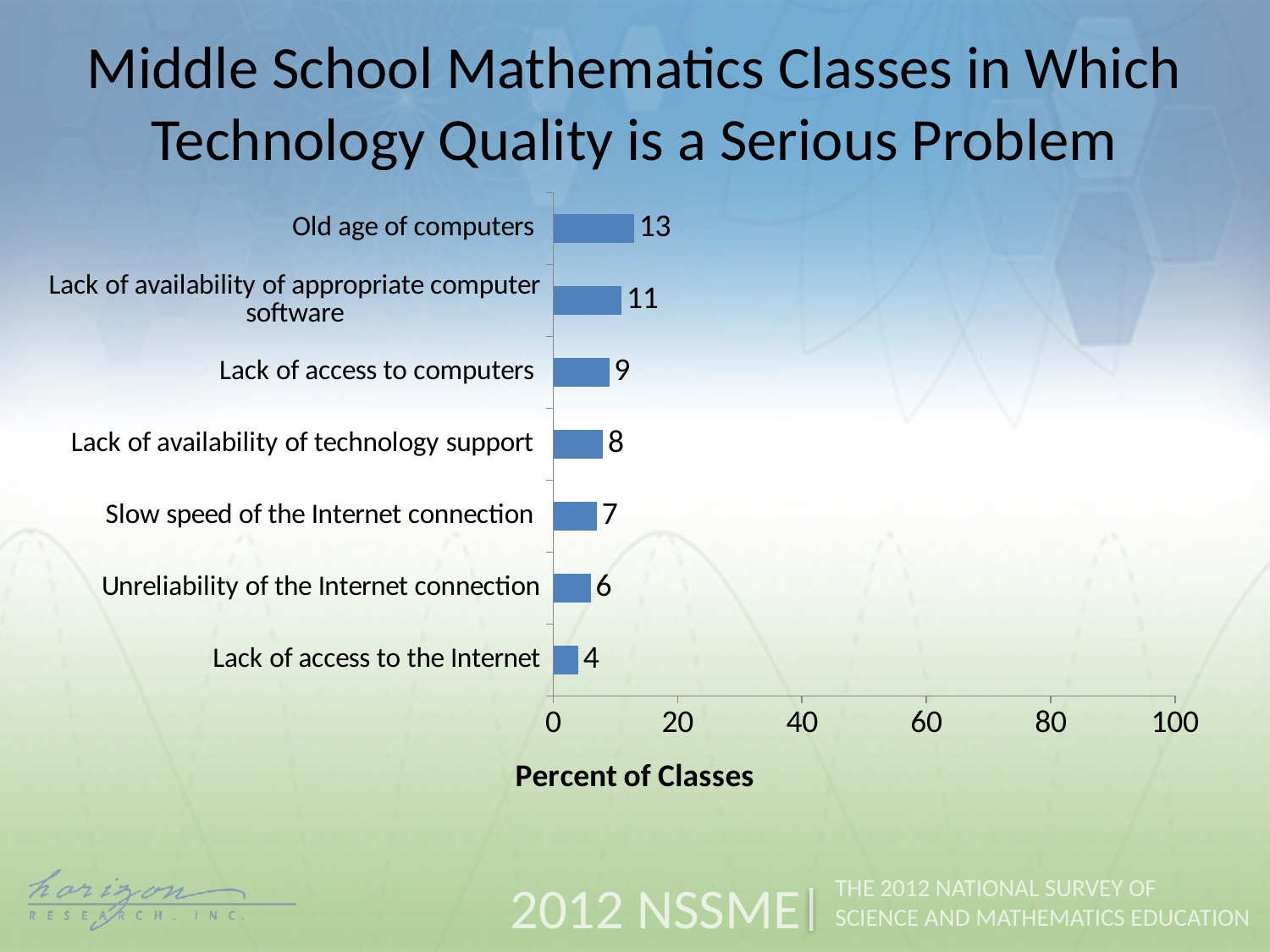
Which category has the lowest value? Lack of access to the Internet What is the value for Slow speed of the Internet connection? 7 What kind of chart is shown on the slide? bar chart Which is larger, the value for Lack of access to computers or the value for Unreliability of the Internet connection? Lack of access to computers Which category has the highest value? Old age of computers What is the value for Lack of availability of appropriate computer software? 11 How many categories are shown in the chart? 7 What is the label of the horizontal axis? Percent of Classes Is the value for Lack of availability of technology support greater or less than 20? less What is the difference between the values for Lack of availability of appropriate computer software and Lack of access to computers? 2 What is the value for Old age of computers? 13 What is the difference between the values for Old age of computers and Lack of access to the Internet? 9